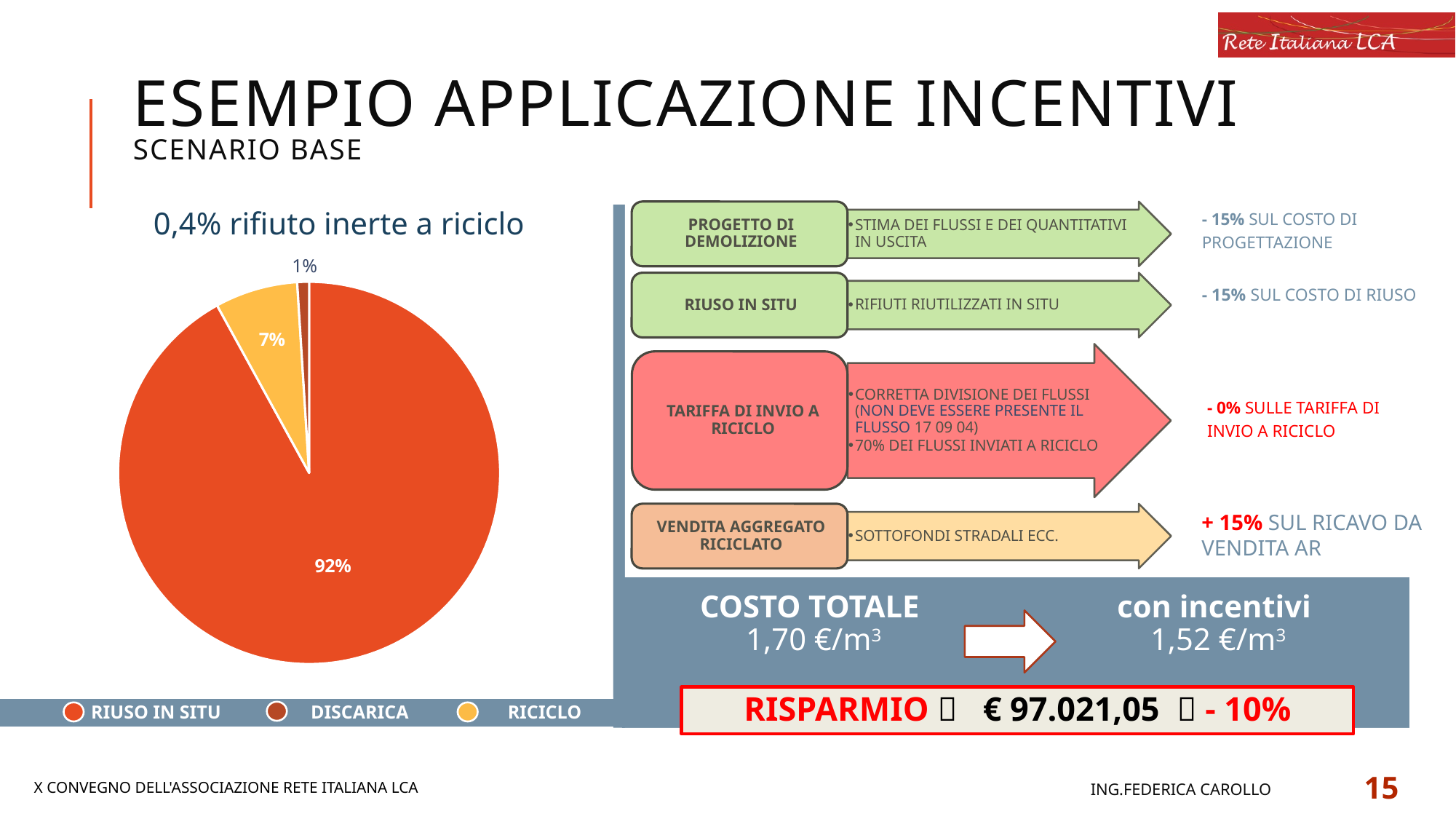
Which category has the largest slice in the pie chart? RIUSO IN SITU What percentage of the pie chart is RICICLO? 7% What is the title of the pie chart? 0,4% rifiuto inerte a riciclo What is the difference in percentage points between RIUSO IN SITU and RICICLO in the pie chart? 85 Which category has the smallest slice in the pie chart? DISCARICA How many slices does the pie chart have? 3 How many entries does the pie chart legend list? 3 What type of chart is shown on the left of the slide? pie chart What percentage of the pie chart is RIUSO IN SITU? 92% What percentage of the pie chart is DISCARICA? 1% What colour is the RICICLO slice in the pie chart? yellow Which is larger in the pie chart, RICICLO or DISCARICA? RICICLO